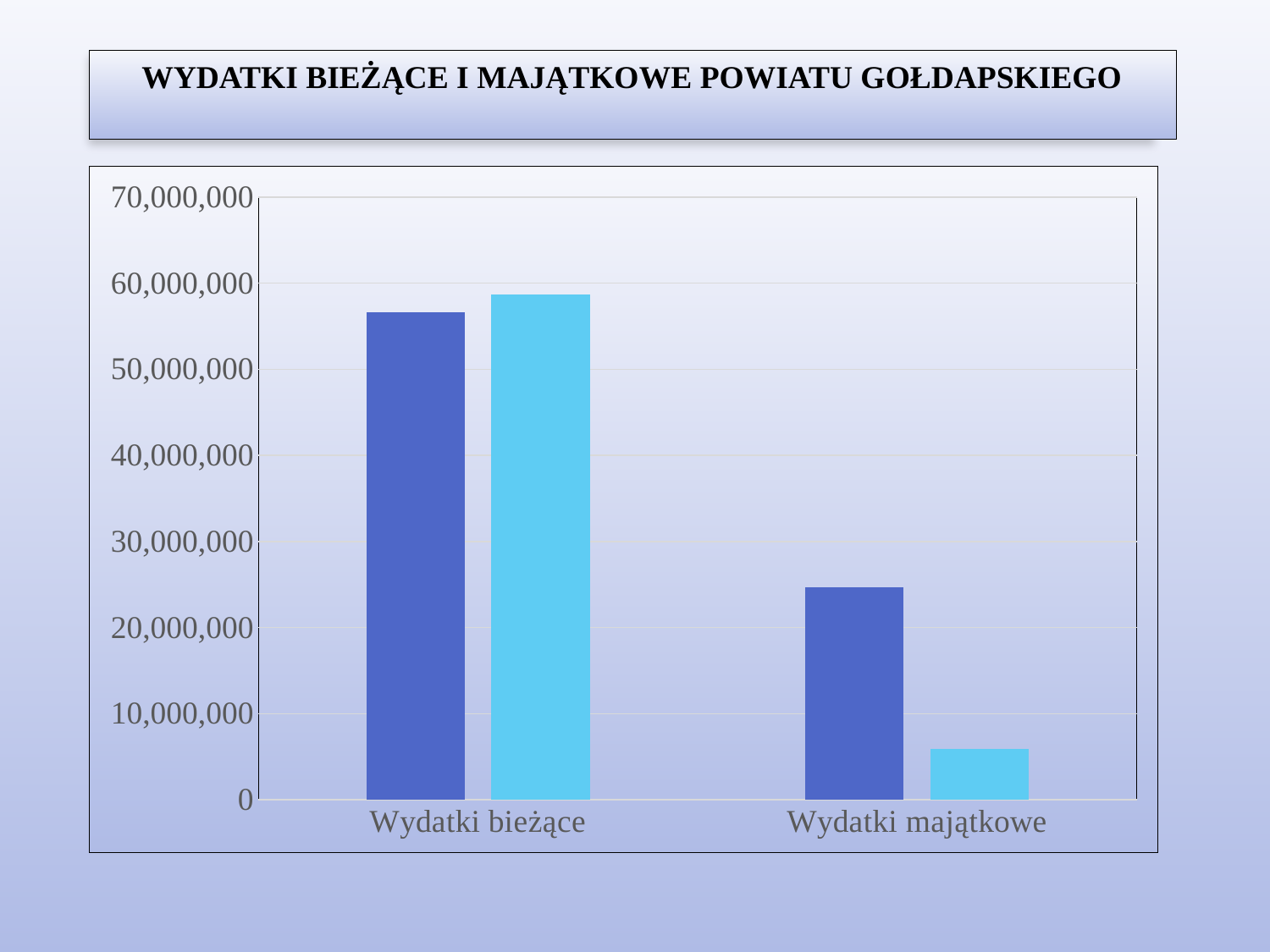
Is the dark blue bar for Wydatki majątkowe greater or less than 20,000,000? greater For Wydatki majątkowe, which bar is larger, the dark blue one or the light blue one? dark blue What is the title shown above the chart? WYDATKI BIEŻĄCE I MAJĄTKOWE POWIATU GOŁDAPSKIEGO Which category has the higher dark blue bar? Wydatki bieżące What kind of chart is shown on the slide? bar chart Which category has the lowest light blue bar? Wydatki majątkowe Is the dark blue bar for Wydatki bieżące greater or less than 50,000,000? greater Is the light blue bar for Wydatki majątkowe greater or less than 10,000,000? less Do the light blue bars rise or fall from Wydatki bieżące to Wydatki majątkowe? fall What is the highest value shown on the vertical axis of the chart? 70,000,000 How many categories are shown on the x axis of the chart? 2